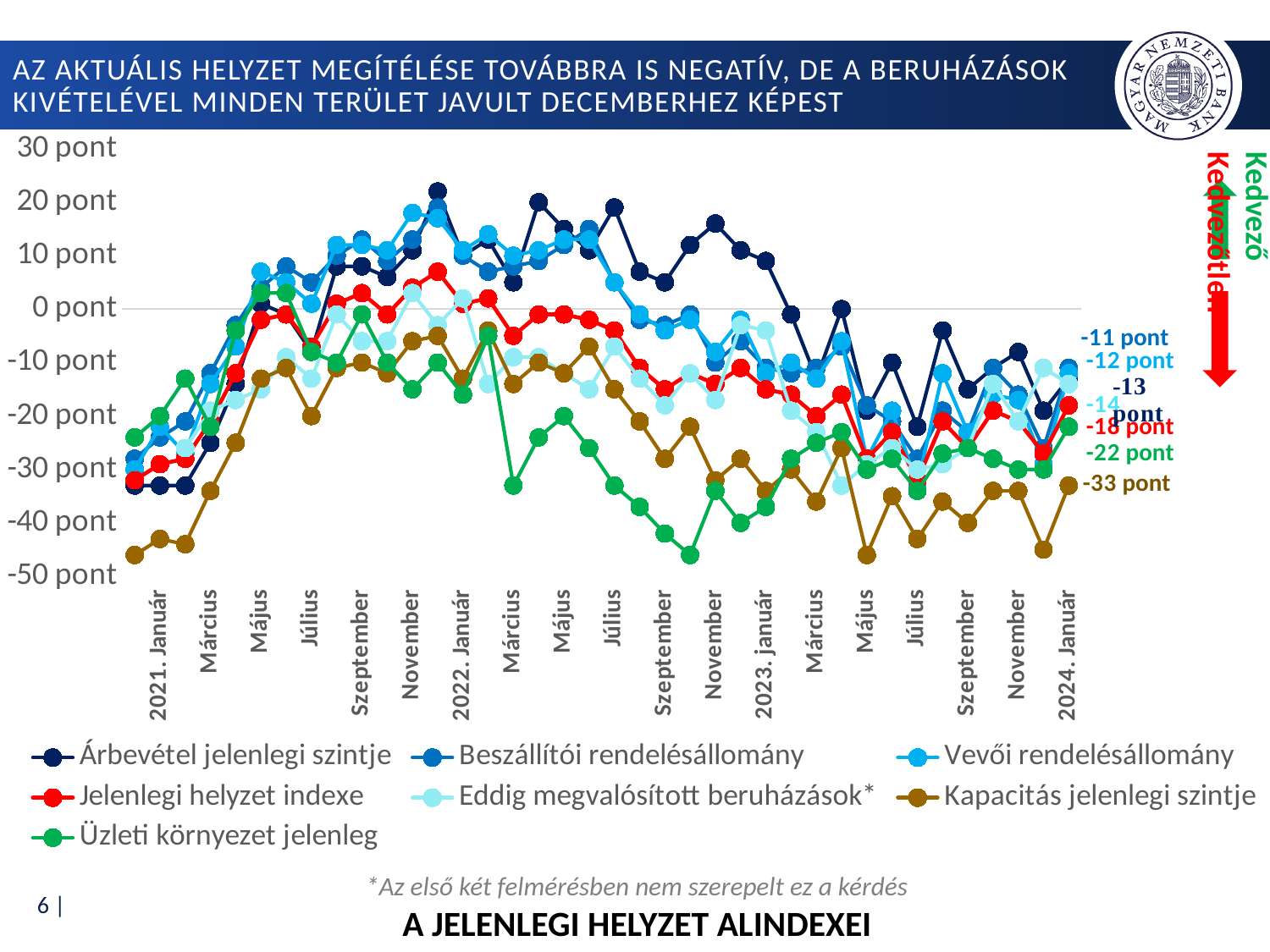
How many series does the legend list? 7 Which series has the lowest value at 2024. Január? Kapacitás jelenlegi szintje What is the value of Jelenlegi helyzet indexe at 2024. Január, as labelled at the end of the line? -18 pont What is the value of Üzleti környezet jelenleg at 2024. Január, as labelled at the end of the line? -22 pont What is the difference between the 2024. Január values of Jelenlegi helyzet indexe (-18 pont) and Kapacitás jelenlegi szintje (-33 pont)? 15 pont What is the value of Kapacitás jelenlegi szintje at 2024. Január, as labelled at the end of the line? -33 pont Does Kapacitás jelenlegi szintje rise or fall between 2021. Január and Május 2021? rise What does the footnote marked with an asterisk say about Eddig megvalósított beruházások? Az első két felmérésben nem szerepelt ez a kérdés What kind of chart is shown on the slide? line chart Is the value of Kapacitás jelenlegi szintje at 2021. Január greater or less than -40 pont? less At 2024. Január, which is higher: Üzleti környezet jelenleg or Kapacitás jelenlegi szintje? Üzleti környezet jelenleg Is the peak value of Árbevétel jelenlegi szintje around the end of 2021 greater or less than 20 pont? greater